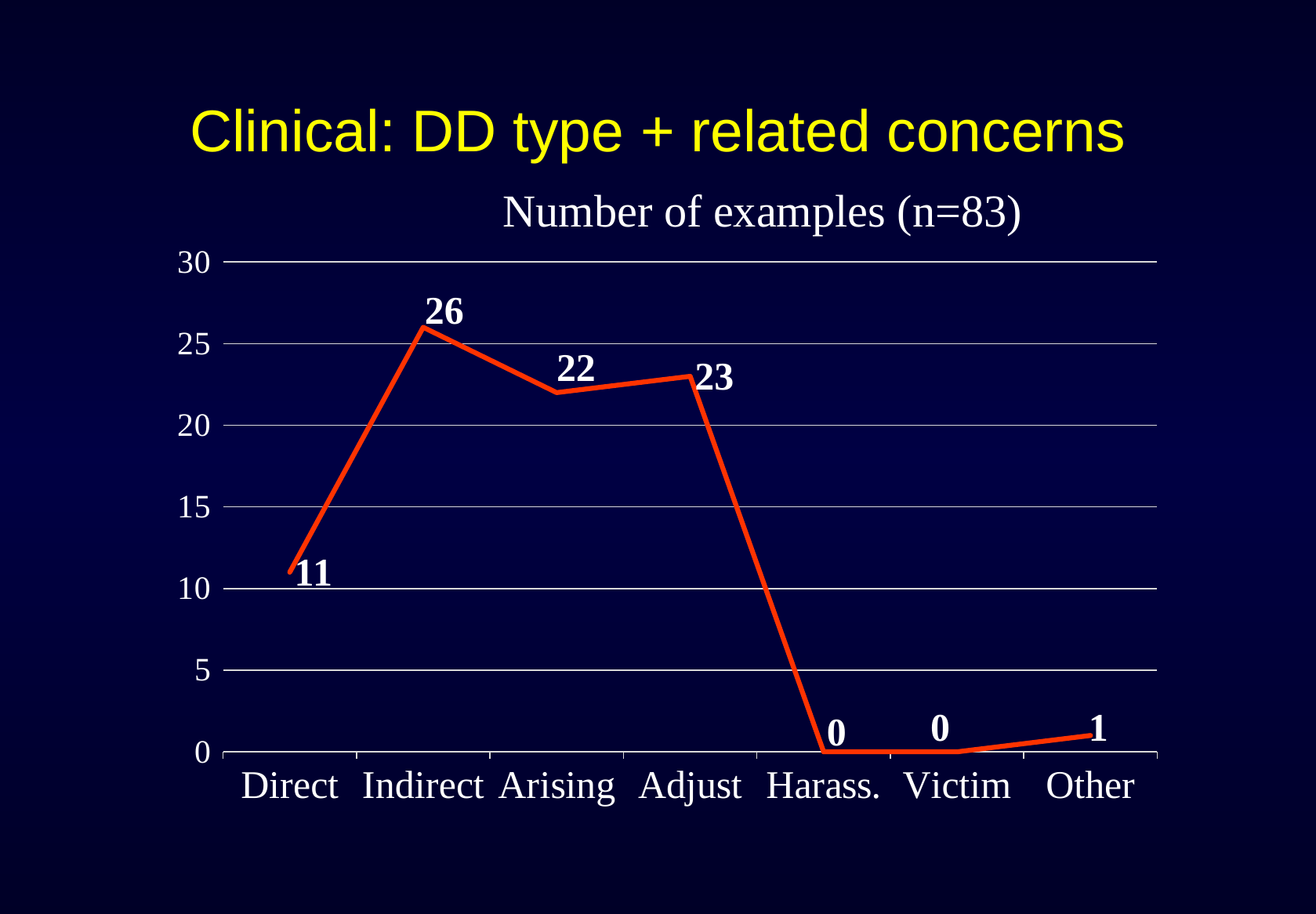
What is the value for Other? 1 What is the difference between the values for Indirect and Arising? 4 Which category has the highest value? Indirect Which is larger, the value for Arising or the value for Adjust? Adjust What is the value for Direct? 11 What is the difference between the values for Adjust and Direct? 12 What is the value for Indirect? 26 Is the value for Direct greater or less than 15? less How many categories are shown on the x axis? 7 What is the title of the chart? Number of examples (n=83) What kind of chart is shown on the slide? line chart What is the value for Adjust? 23